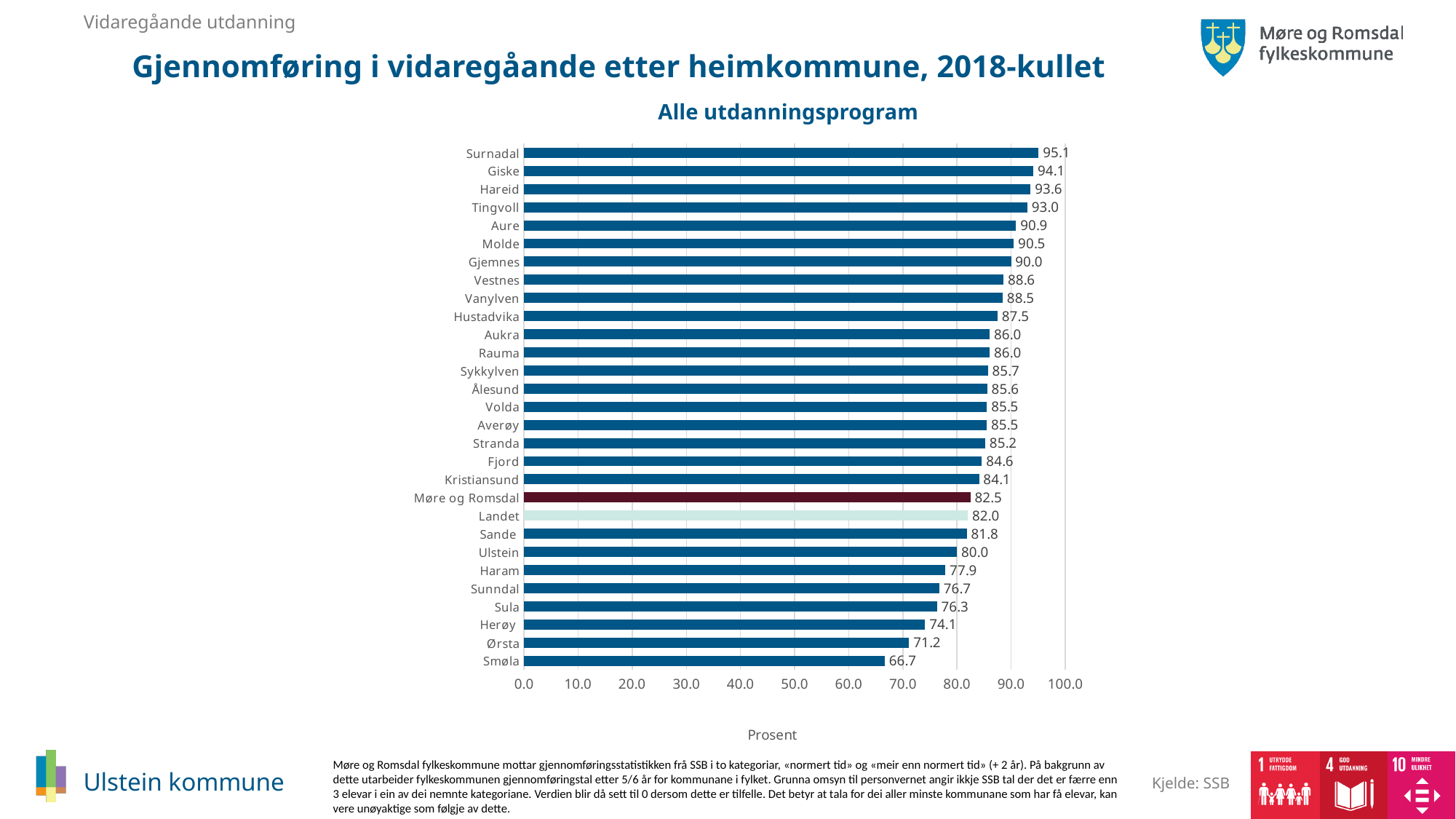
What is the difference between the values for Surnadal and Smøla? 28.4 Which category has the highest value? Surnadal What is the value for Landet? 82.0 What is the value for Møre og Romsdal? 82.5 Which is larger, the value for Giske or the value for Hareid? Giske What is the value for Ulstein? 80.0 Which category has the lowest value? Smøla Is the value for Herøy greater or less than 80.0? less What is the title shown above the chart? Alle utdanningsprogram What is the difference between the values for Møre og Romsdal and Ulstein? 2.5 What kind of chart is shown on the slide? bar chart How many categories are shown in the chart? 29